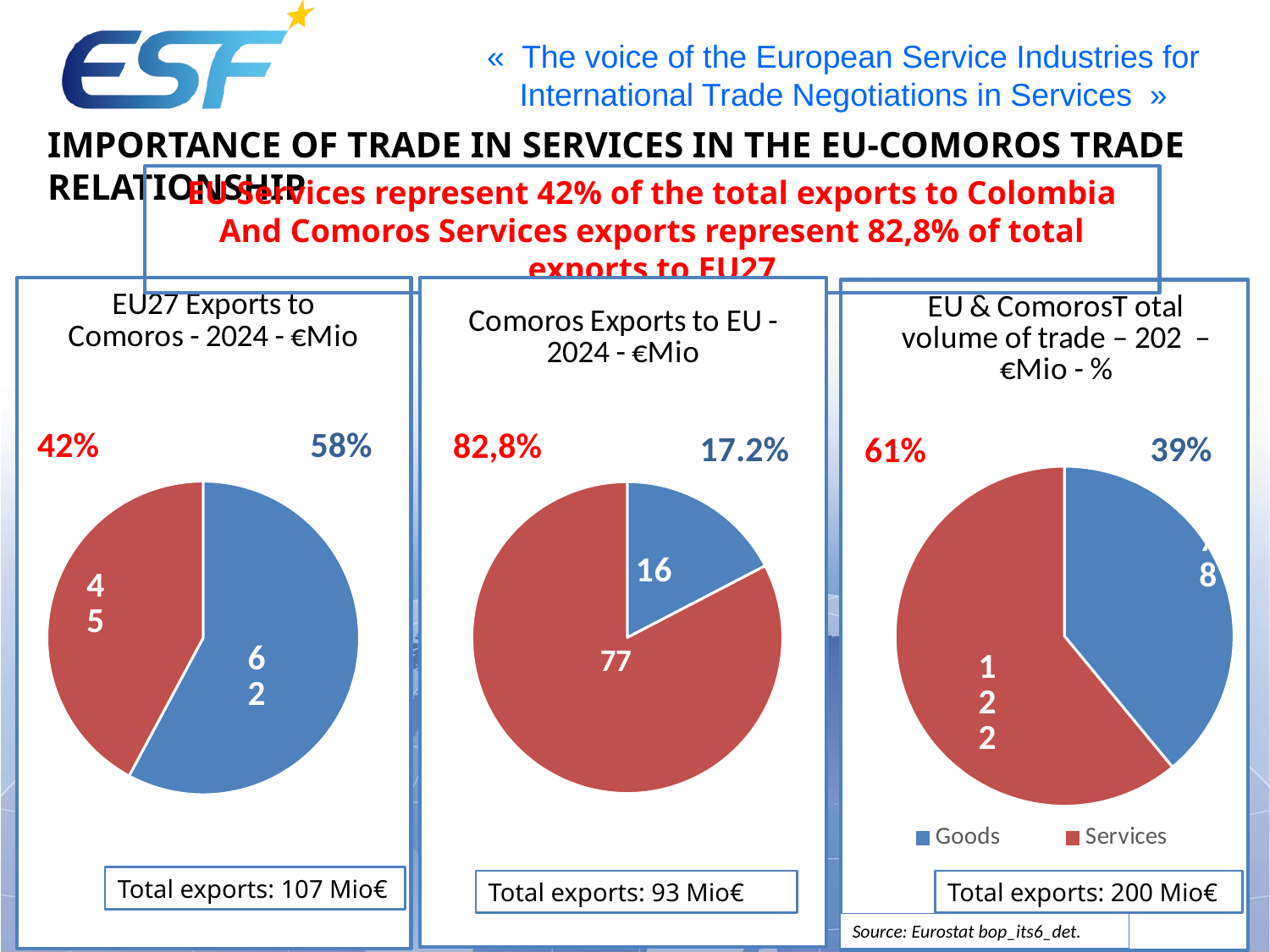
In the 'EU & Comoros Total volume of trade' chart, what percentage share do Goods represent? 39% In the 'Comoros Exports to EU - 2024 - €Mio' chart, what percentage share does the blue slice represent? 17.2% What kind of chart is used on this slide? Pie chart In the 'EU27 Exports to Comoros - 2024 - €Mio' chart, what value is shown on the red slice? 45 In the 'EU27 Exports to Comoros - 2024 - €Mio' chart, what value is shown on the blue slice? 62 How many entries does the legend of the 'EU & Comoros Total volume of trade' chart list? 2 In the 'EU27 Exports to Comoros - 2024 - €Mio' chart, what percentage share does the red slice represent? 42% In the 'EU27 Exports to Comoros - 2024 - €Mio' chart, what is the difference between the blue slice value and the red slice value? 17 In the 'EU & Comoros Total volume of trade' chart, what value is shown for Services? 122 In the 'Comoros Exports to EU - 2024 - €Mio' chart, which slice is larger, the blue one or the red one? The red one What total exports figure is shown below the 'Comoros Exports to EU - 2024 - €Mio' chart? 93 Mio€ In the 'Comoros Exports to EU - 2024 - €Mio' chart, what value is shown on the red slice? 77